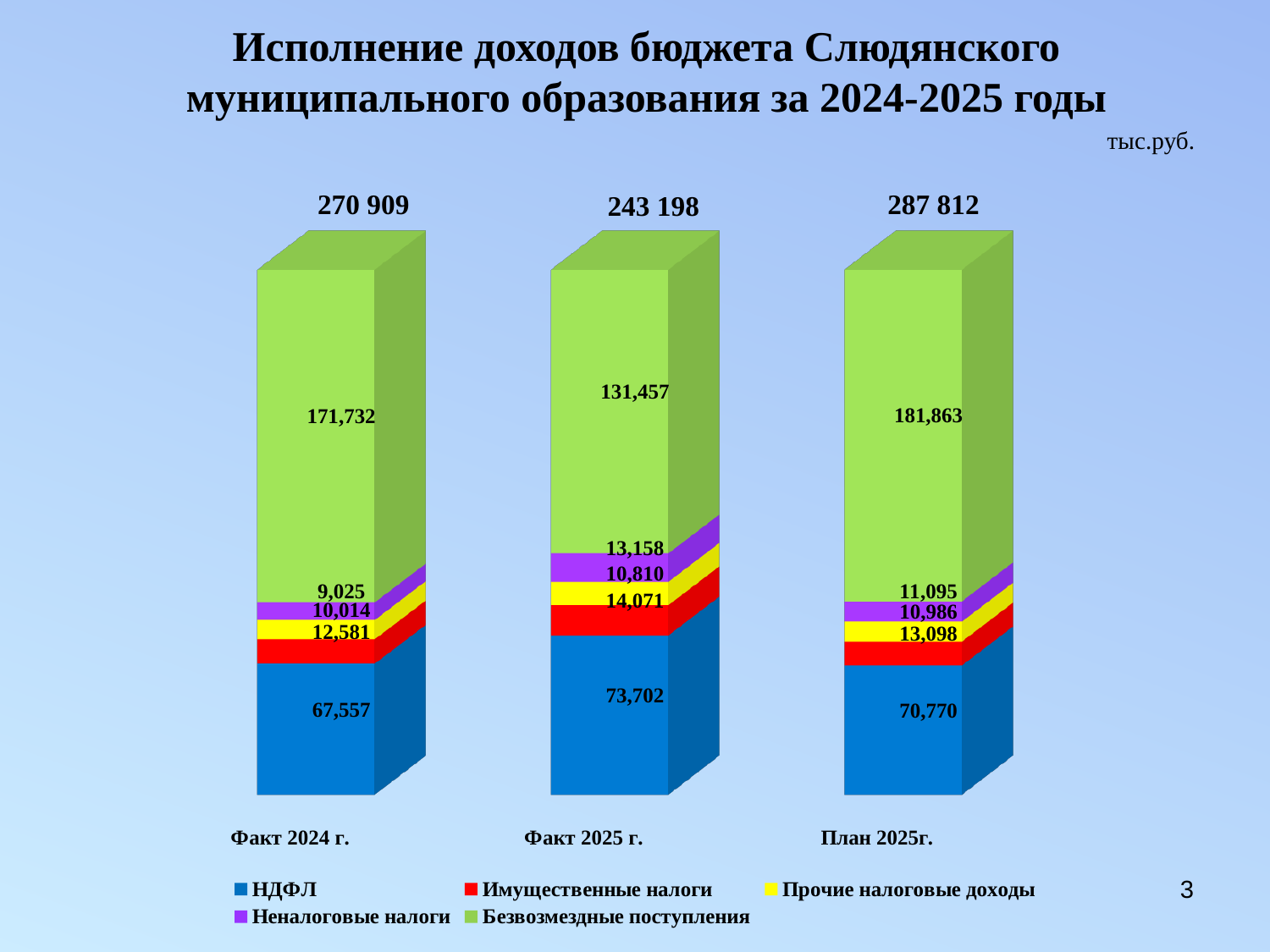
What type of chart is shown on the slide? Stacked bar chart What unit of measurement is indicated on the slide? тыс.руб. What is the value of Безвозмездные поступления for Факт 2025 г.? 131,457 Which is larger: Неналоговые налоги for Факт 2025 г. or for План 2025г.? Факт 2025 г. How many bars (categories) are shown in the chart? 3 How many series does the legend list? 5 Which category has the lowest total? Факт 2025 г. Which category has the highest value of Безвозмездные поступления? План 2025г. What is the difference between НДФЛ for Факт 2025 г. and НДФЛ for Факт 2024 г.? 6,145 What is the value of Имущественные налоги for План 2025г.? 13,098 What is the value of НДФЛ for Факт 2024 г.? 67,557 What is the total shown above the bar for План 2025г.? 287 812